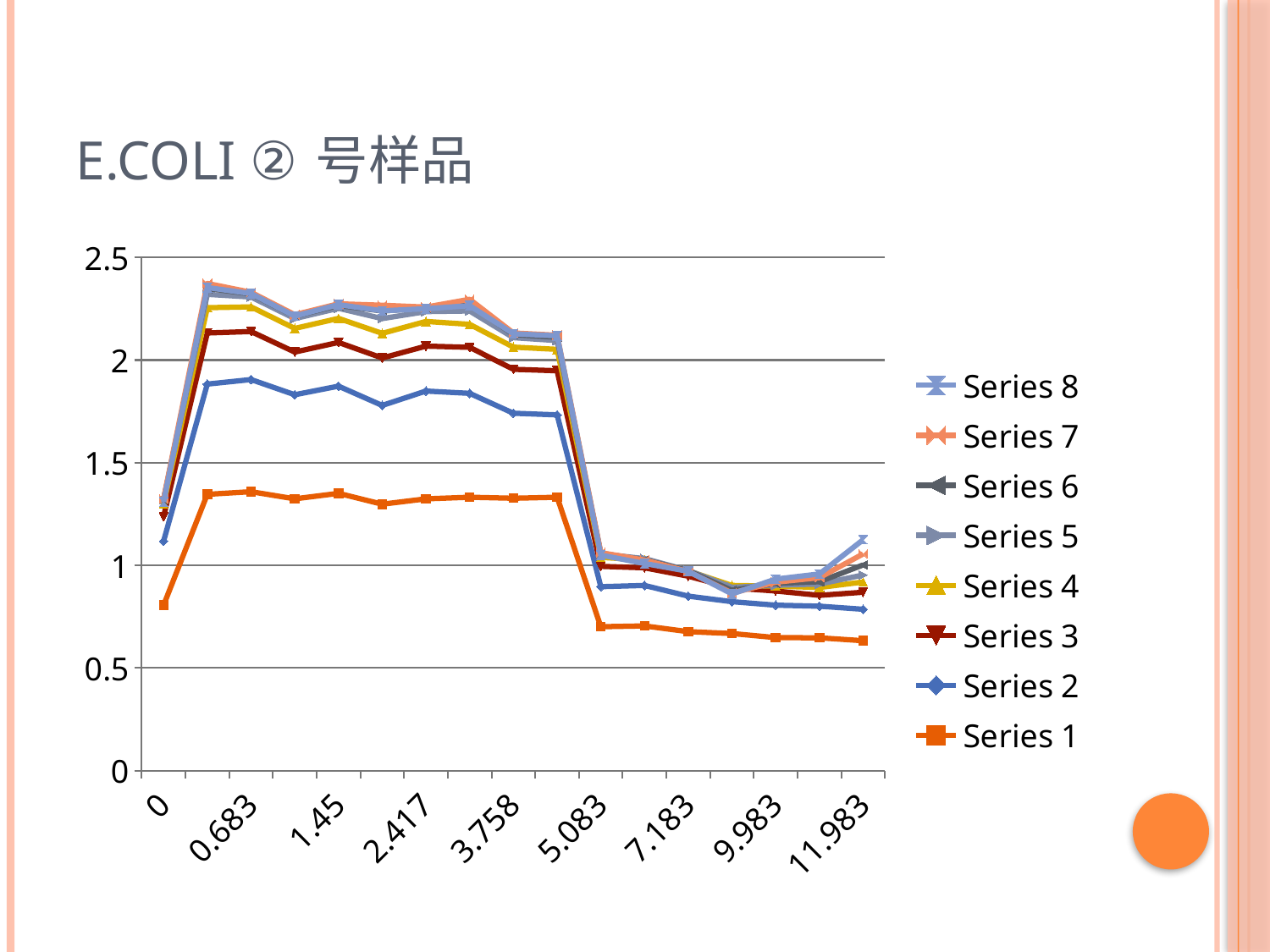
Is the value for Series 2 at x = 0.683 greater or less than 2? less What is the title of the slide? E.COLI ② 号样品 Do the values of Series 1 rise or fall from x = 5.083 to x = 11.983? fall Which series has the lowest values across the whole chart? Series 1 Is the value for Series 1 at x = 0 greater or less than 1? less Is the value for Series 1 at x = 0.683 greater or less than 1? greater At x = 0.683, which is larger: Series 1 or Series 8? Series 8 How many series does the legend list? 8 Which series is plotted with orange square markers? Series 1 What kind of chart is shown on the slide? line chart